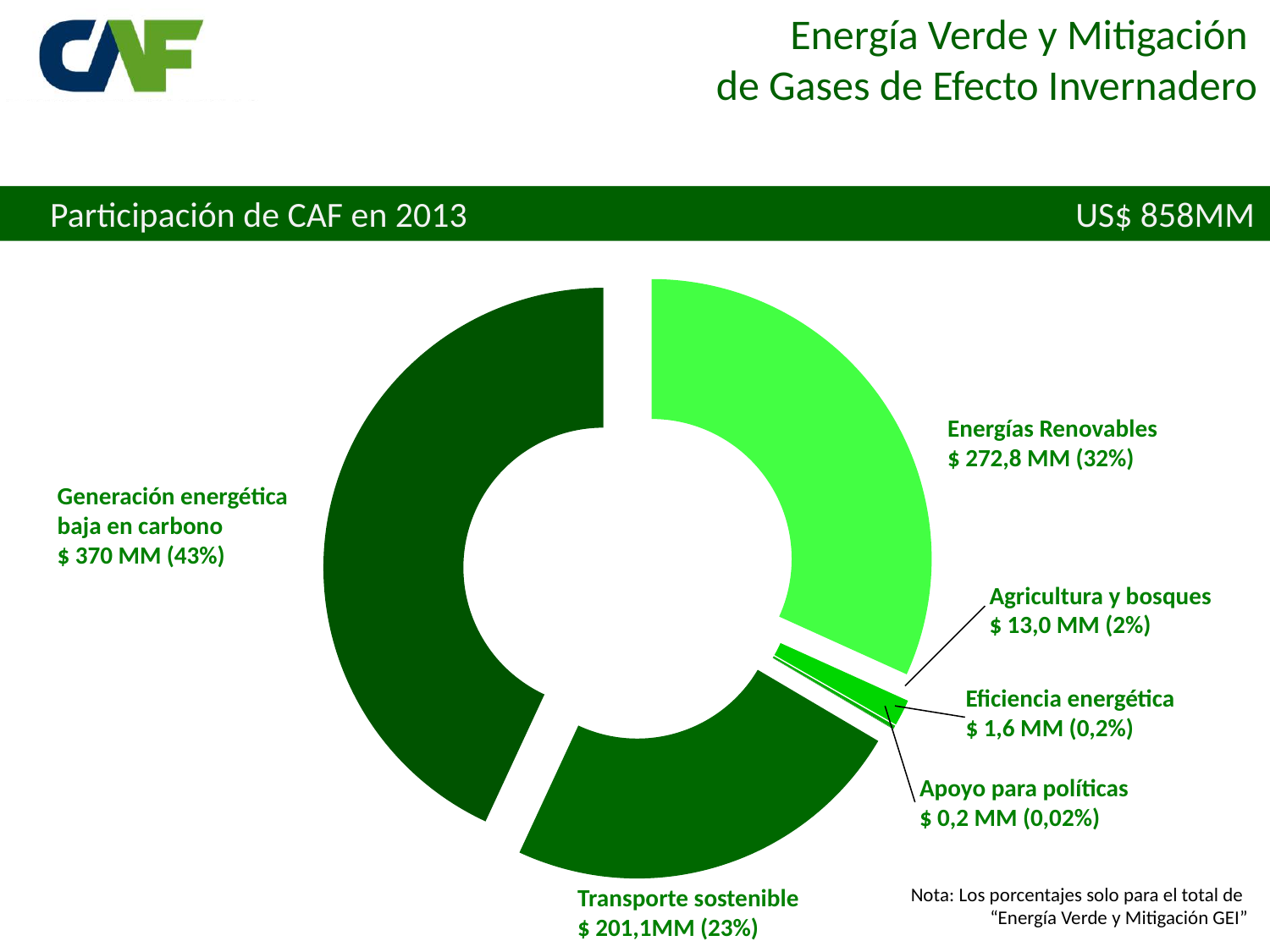
What total amount is shown for CAF's participation in 2013? US$ 858MM What is the value for Transporte sostenible? $ 201,1MM What is the value for Energías Renovables? $ 272,8 MM Which category has the largest share of the chart? Generación energética baja en carbono What is the value for Agricultura y bosques? $ 13,0 MM What share of the total does Generación energética baja en carbono represent? 43% How many categories does the donut chart show? 6 Which category has the smallest share of the chart? Apoyo para políticas What share of the total does Apoyo para políticas represent? 0,02% What is the value for Eficiencia energética? $ 1,6 MM Which is larger, Energías Renovables or Transporte sostenible? Energías Renovables What kind of chart is shown on the slide? Pie chart (donut)